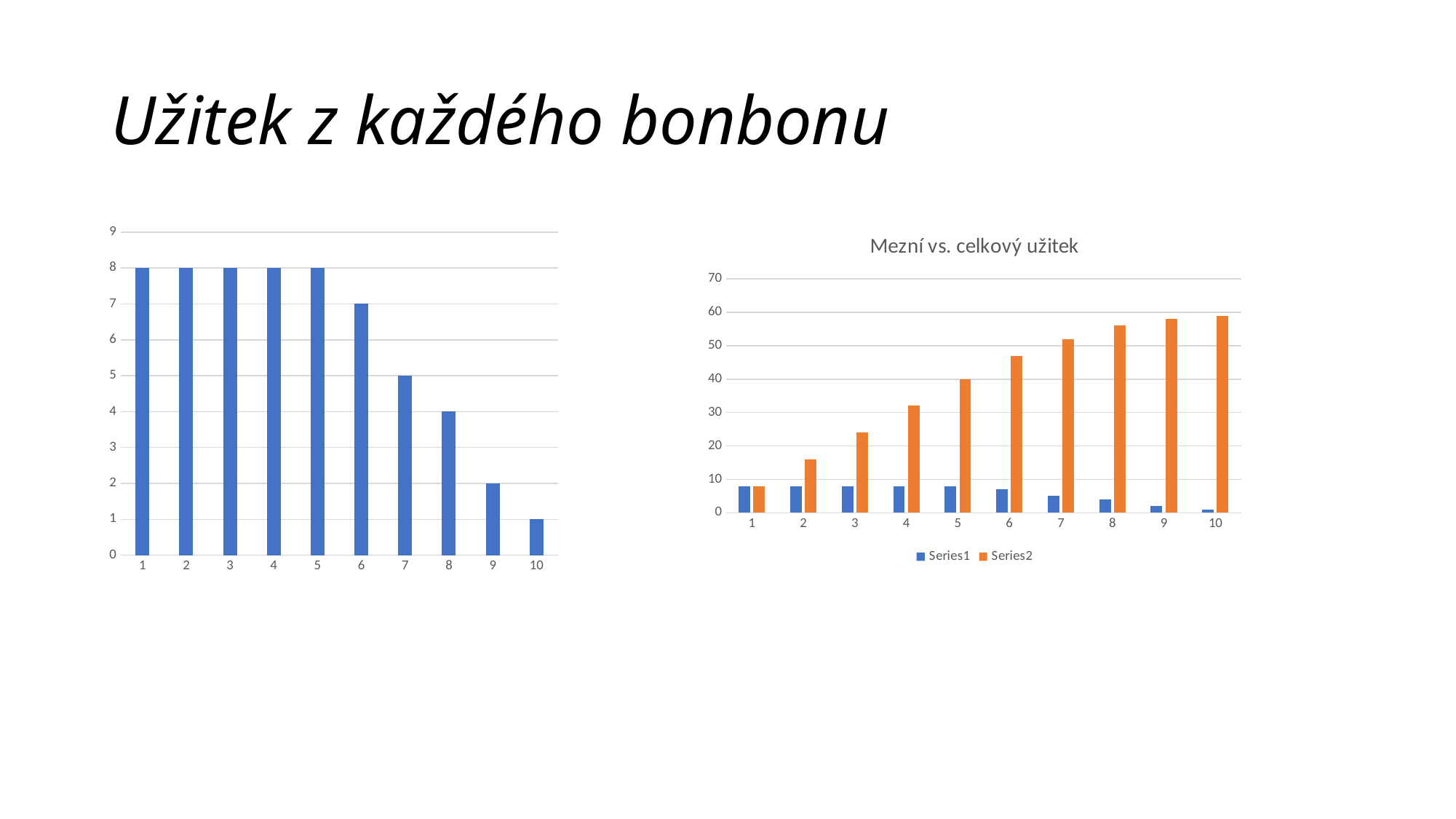
On the left chart, do the values rise or fall as you move from category 1 to category 10? fall On the left chart, is the value for category 6 larger or smaller than the value for category 8? larger On the left chart, what is the difference between the values for category 1 and category 9? 6 On the left chart, how many categories are shown on the x axis? 10 What kind of chart is the chart titled 'Mezní vs. celkový užitek'? bar chart On the chart 'Mezní vs. celkový užitek', which category has the highest Series2 value? 10 On the left chart, what is the value for category 7? 5 On the chart 'Mezní vs. celkový užitek', is the Series2 value for category 10 greater or less than 50? greater How many series does the legend of the chart 'Mezní vs. celkový užitek' list? 2 What is the title of the chart on the right side of the slide? Mezní vs. celkový užitek On the left chart, which category has the lowest value? 10 On the left chart, what is the value for category 10? 1